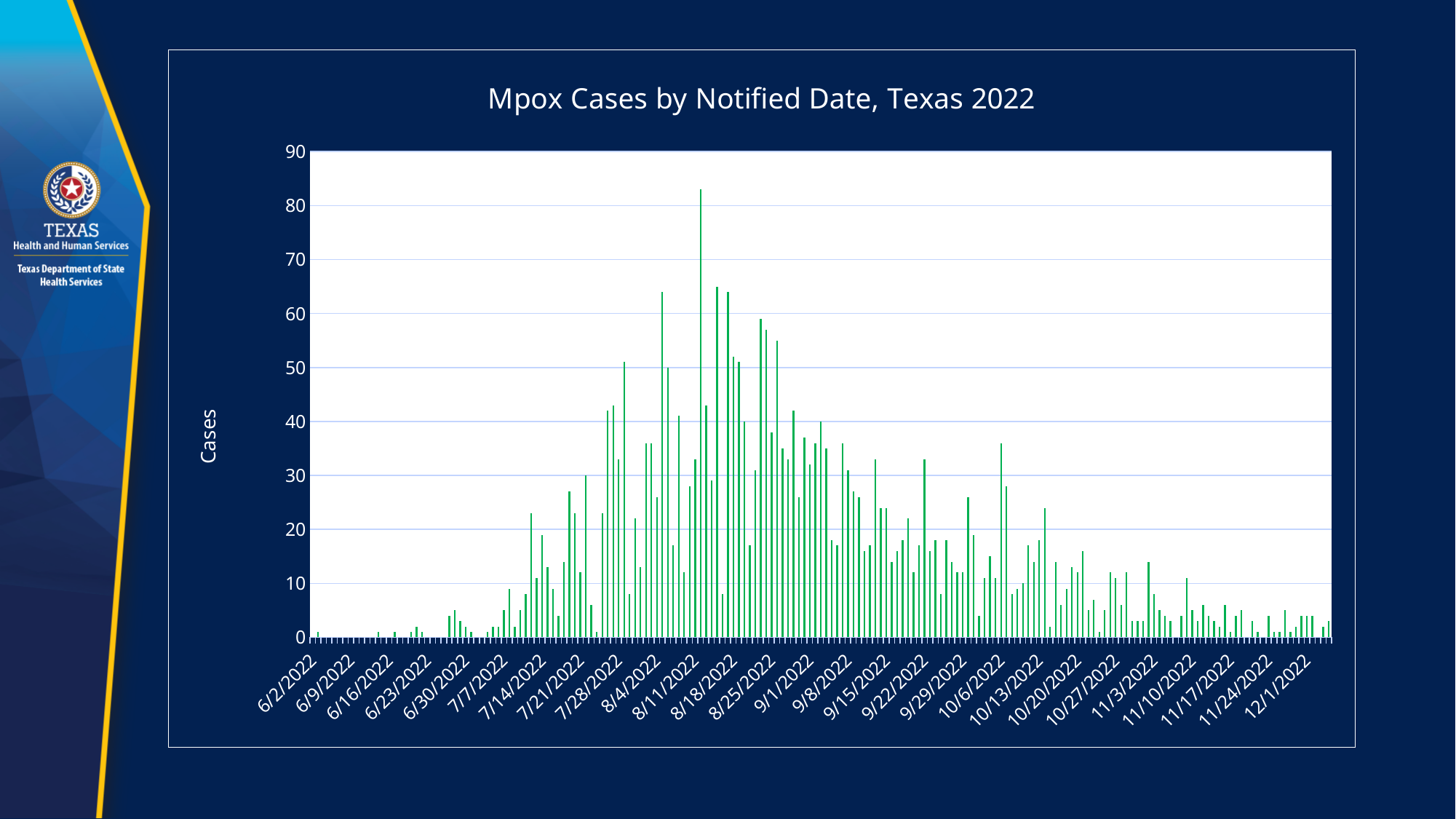
Is the value for 7/28/2022 greater or less than 30? greater What is the title of the chart? Mpox Cases by Notified Date, Texas 2022 What is the highest value shown on the vertical axis? 90 Is the value for 12/1/2022 greater or less than 10? less Is the tallest bar in the chart greater or less than 80? greater Do the values generally rise or fall from 8/18/2022 to 12/1/2022? fall In which month does the tallest bar of the chart occur? August Do the values generally rise or fall from 6/2/2022 to 8/4/2022? rise What is the label on the vertical axis of the chart? Cases What kind of chart is shown on the slide? bar chart Which has the larger value, 6/2/2022 or 7/28/2022? 7/28/2022